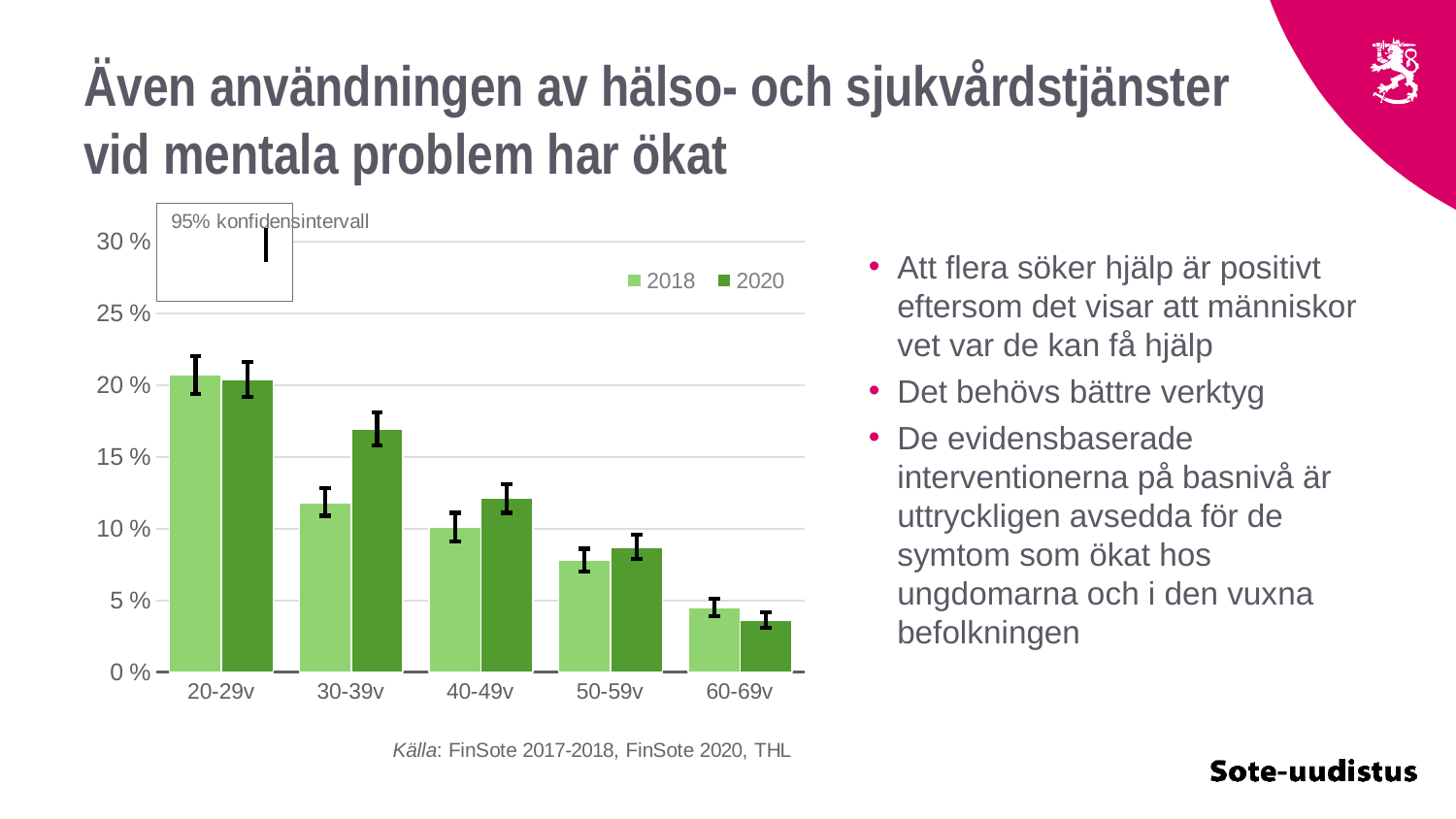
What do the black error bars on the chart represent, according to the label in the chart? 95% konfidensintervall Do the 2018 values rise or fall as the age groups increase along the x axis? fall How many age groups are shown on the x axis of the chart? 5 Is the 2018 value for 50-59v greater or less than 10 %? less For the 60-69v age group, which is larger, the 2018 value or the 2020 value? 2018 Which age group has the lowest value for 2018? 60-69v Which age group has the highest value for 2020? 20-29v For the 30-39v age group, which is larger, the 2018 value or the 2020 value? 2020 Is the 2020 value for 30-39v greater or less than 15 %? greater How many series does the chart legend list? 2 What kind of chart is shown on the slide? bar chart Is the 2020 value for 40-49v greater or less than 10 %? greater